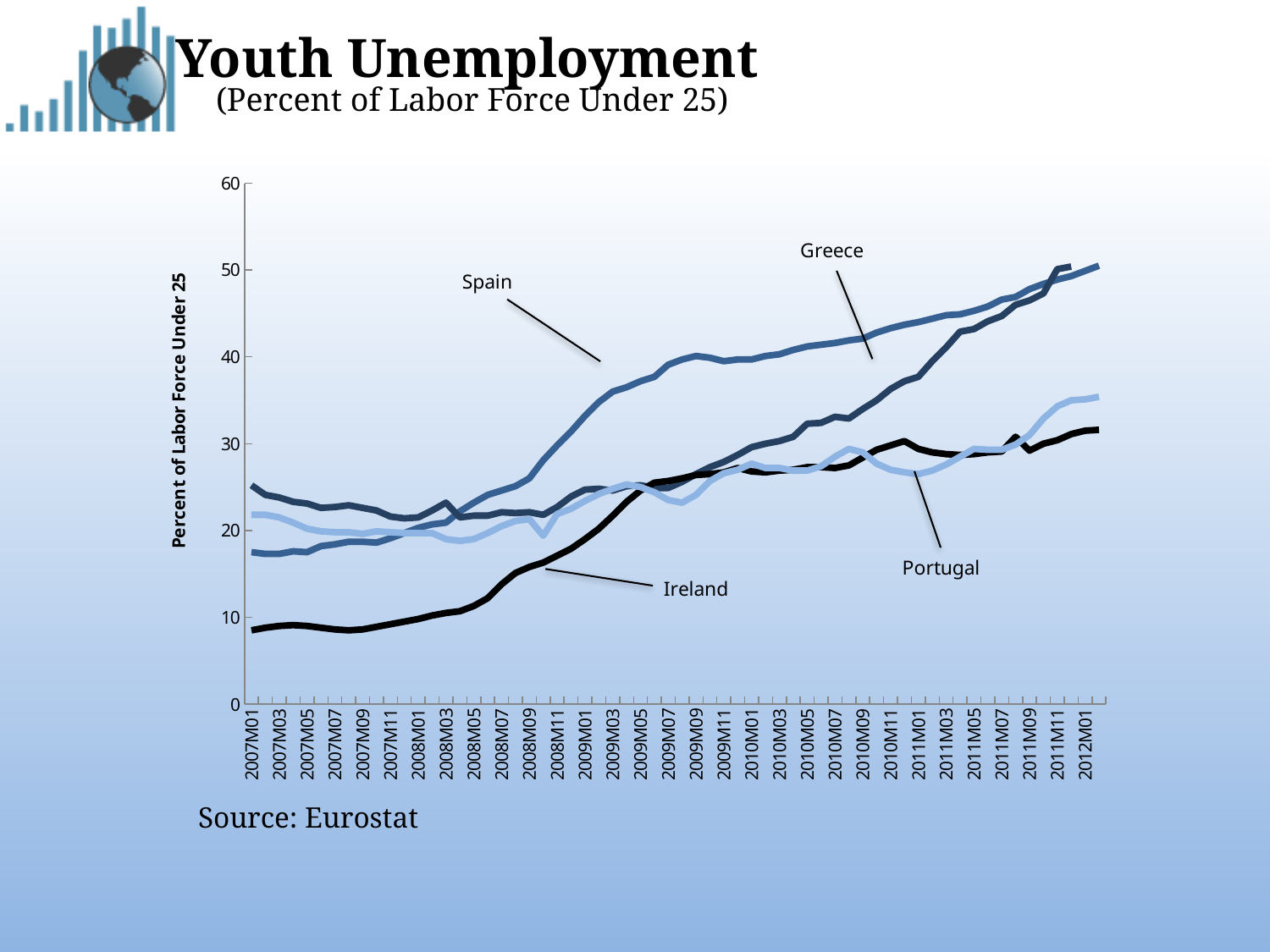
What kind of chart is shown on the slide? line chart Is the value for Ireland at 2007M01 greater or less than 10? less Is the value for Greece at 2010M09 greater or less than 30? greater Which country has the highest youth unemployment rate at 2007M01? Greece At 2010M01, which is larger, the value for Spain or the value for Ireland? Spain What is the label on the vertical axis of the chart? Percent of Labor Force Under 25 Which country has the highest youth unemployment rate at 2010M01? Spain Is the value for Spain at 2007M01 greater or less than 20? less How many countries are plotted as lines on the chart? 4 Which country has the lowest youth unemployment rate at 2007M01? Ireland Does the Ireland line rise or fall from 2007M01 to 2012M01? rise